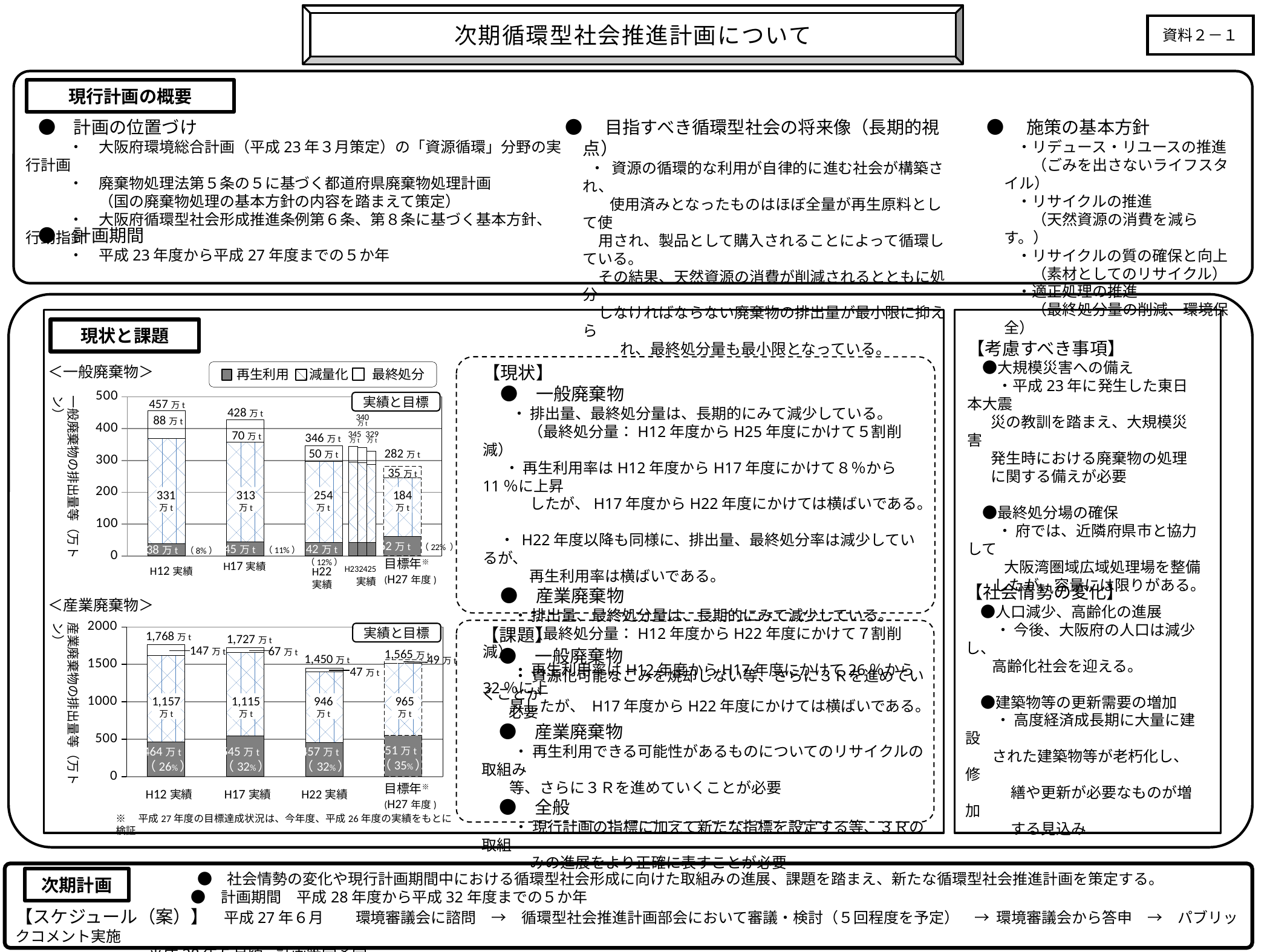
In the <一般廃棄物> chart, do the bar totals rise or fall from H12実績 to H22実績? Fall In the <産業廃棄物> chart, which total is larger: H17実績 or 目標年 (H27年度)? H17実績 What kind of chart is the <一般廃棄物> chart? Stacked bar chart In the <産業廃棄物> chart, which bar has the highest total? H12実績 In the <産業廃棄物> chart, what is the total labeled above the H22実績 bar? 1,450万t In the <一般廃棄物> chart, what is the total labeled above the H12実績 bar? 457万t How many series does the legend of the <一般廃棄物> chart list? 3 In the <産業廃棄物> chart, what is the 減量化 value for 目標年 (H27年度)? 965万t In the <一般廃棄物> chart, what is the 最終処分 value for H22実績? 50万t In the <産業廃棄物> chart, what percentage is shown for 再生利用 in the H12実績 bar? 26% In the <一般廃棄物> chart, which bar has the lowest total? 目標年 (H27年度) In the <一般廃棄物> chart, what is the difference between the H12実績 total and the H17実績 total? 29万t